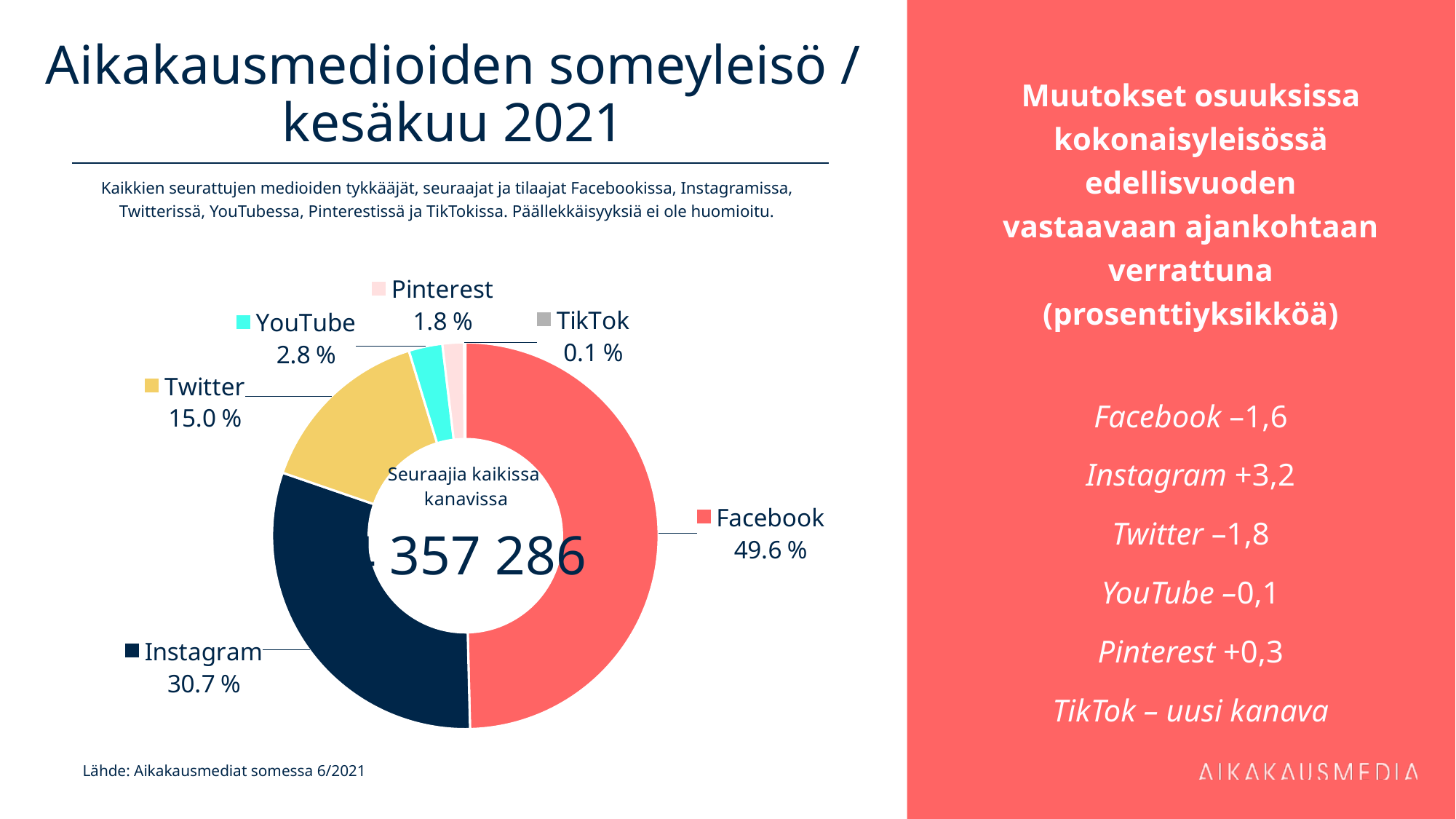
What is the value shown for Instagram? 30.7 % Which is larger, the share for Twitter or the share for YouTube? Twitter Which channel has the smallest share of the pie? TikTok Which channel has the largest share of the pie? Facebook What is the value shown for Twitter? 15.0 % What is the title of the slide? Aikakausmedioiden someyleisö / kesäkuu 2021 What is the value shown for Pinterest? 1.8 % How many channels are shown in the pie chart? 6 What kind of chart is shown on the slide? Pie chart (donut) What is the difference in percentage points between Facebook and Instagram? 18.9 What is the value shown for YouTube? 2.8 % What share of the pie does Facebook hold? 49.6 %